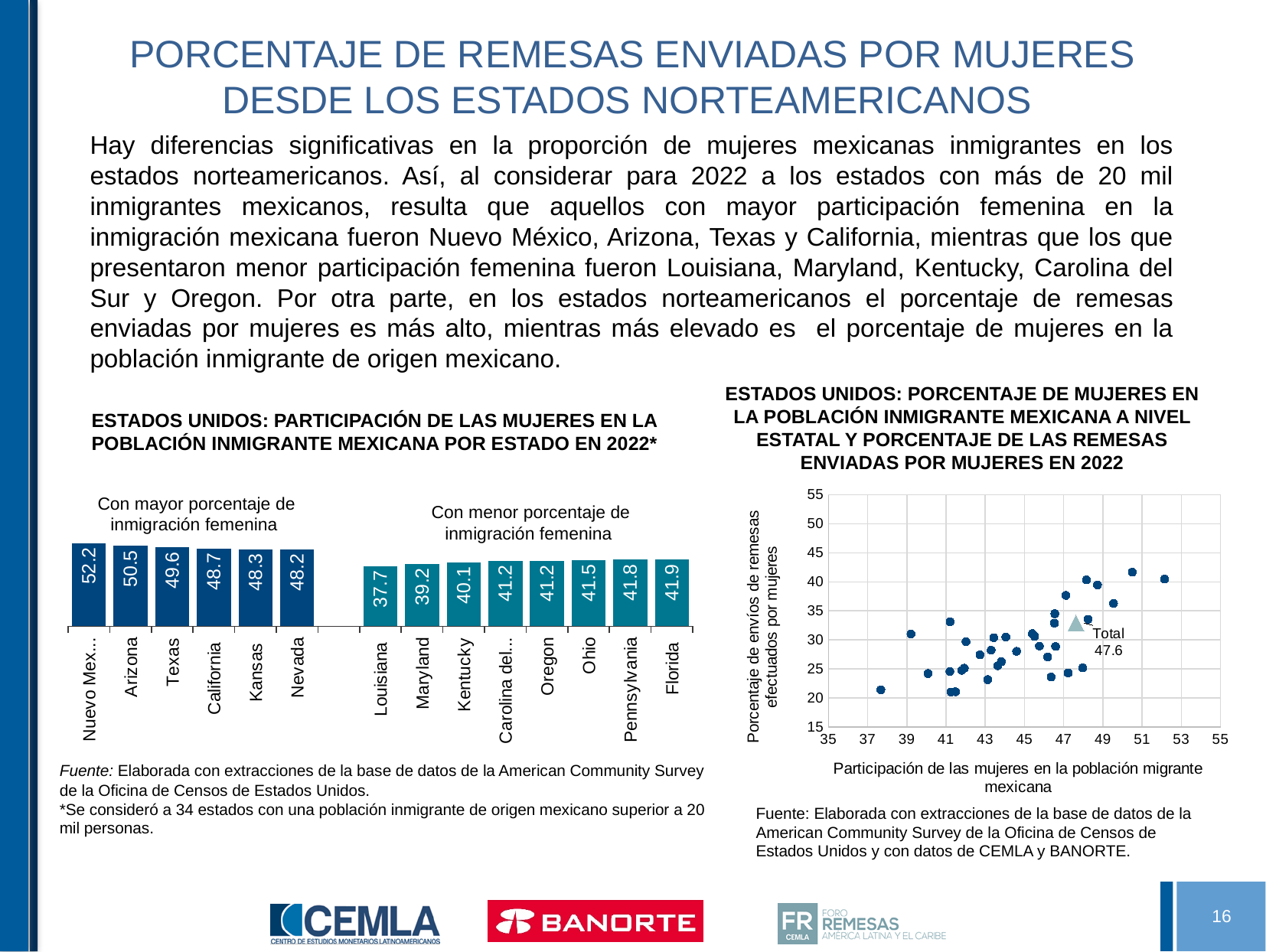
In the bar chart on the left, how many states are shown in the group 'Con mayor porcentaje de inmigración femenina'? 6 What kind of chart is the chart on the right of the slide? Scatter chart In the scatter chart on the right, what is the label of the x axis? Participación de las mujeres en la población migrante mexicana In the bar chart on the left, how many states are shown in the group 'Con menor porcentaje de inmigración femenina'? 8 In the bar chart on the left, what is the value for Louisiana? 37.7 In the bar chart on the left, what is the value for Arizona? 50.5 In the bar chart on the left, which is larger, the value for Kansas or the value for Nevada? Kansas In the bar chart on the left, what is the difference between the values for Texas and Kentucky? 9.5 In the bar chart on the left, what is the value for Florida? 41.9 In the scatter chart on the right, what value is labelled next to the 'Total' marker? 47.6 In the bar chart on the left, which state has the highest value? Nuevo México In the bar chart on the left, which state has the lowest value? Louisiana